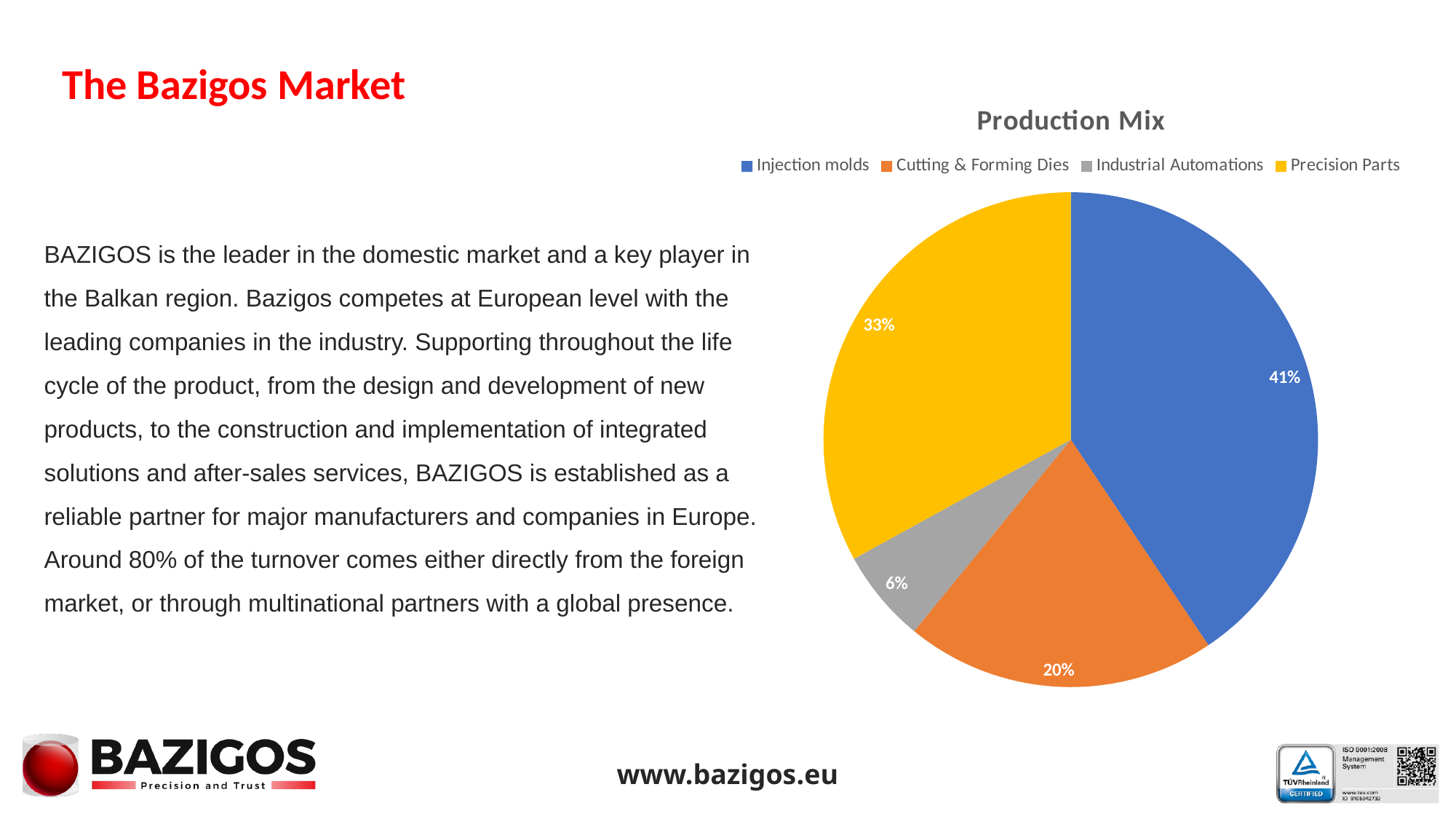
What colour is the Precision Parts slice? yellow What is the title of the chart? Production Mix Which category has the largest share of the production mix? Injection molds Which category has the smallest share of the production mix? Industrial Automations What share of the production mix is Industrial Automations? 6% How many categories does the pie chart show? 4 Which has a larger share, Cutting & Forming Dies or Precision Parts? Precision Parts What share of the production mix is Injection molds? 41% What share of the production mix is Precision Parts? 33% What share of the production mix is Cutting & Forming Dies? 20% What is the difference in percentage points between Injection molds and Precision Parts? 8 What type of chart is shown on the slide? pie chart